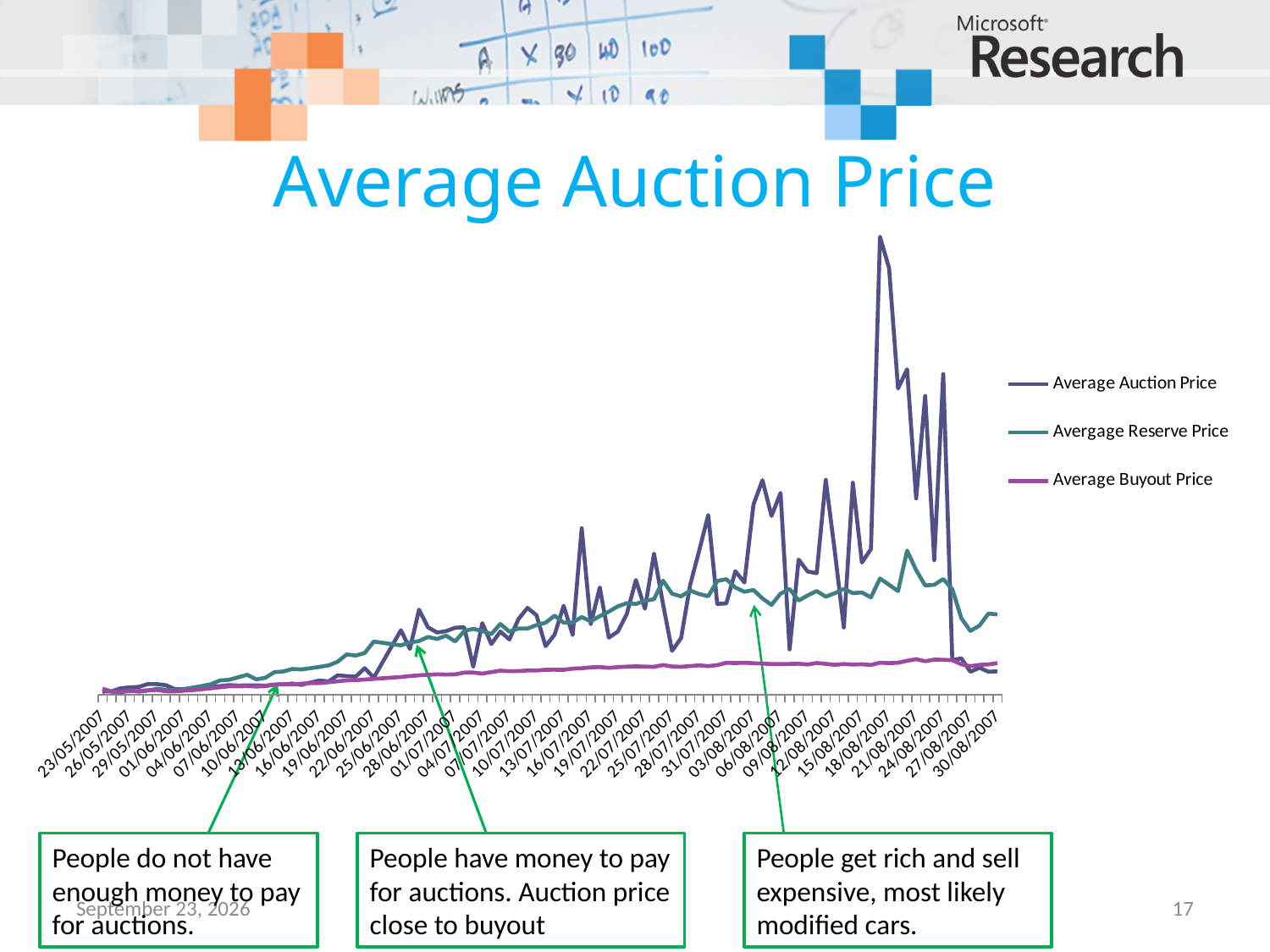
What is the title of the chart? Average Auction Price Around 18/08/2007, which is larger: the Average Auction Price or the Average Buyout Price? Average Auction Price Does the Average Buyout Price generally rise or fall from 23/05/2007 to 24/08/2007? rise What kind of chart is shown on the slide? line chart At 30/08/2007, which is larger: the Avergage Reserve Price or the Average Auction Price? Avergage Reserve Price Which series reaches the highest peak on the chart? Average Auction Price Does the Average Auction Price rise or fall between 18/08/2007 and 30/08/2007? fall Which series is drawn in the magenta/purple line at the bottom of the chart? Average Buyout Price How many series does the legend list? 3 Around 18/08/2007, which is larger: the Average Auction Price or the Avergage Reserve Price? Average Auction Price Does the Avergage Reserve Price generally rise or fall from 23/05/2007 to 21/08/2007? rise